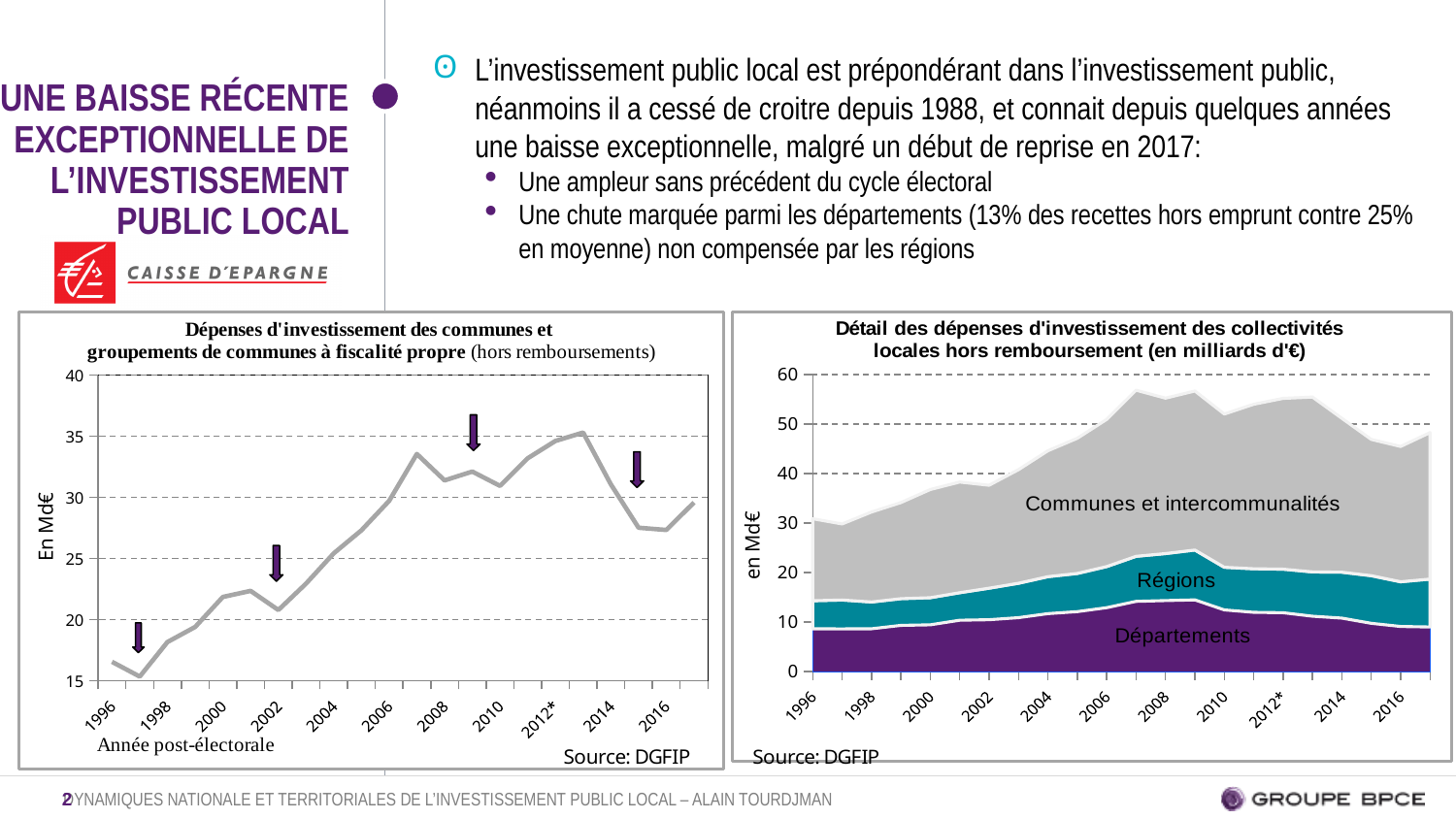
In the right chart, is the total for 1996 greater or less than 40? less In the right chart, which series is at the bottom of the stack? Départements In the left chart, is the value for 2007 greater or less than 30? greater What kind of chart is the right chart, 'Détail des dépenses d'investissement des collectivités locales hors remboursement'? stacked area chart In the left chart, which year has the lowest value? 1997 In the left chart, is the value for 2015 greater or less than 30? less What kind of chart is the left chart, 'Dépenses d'investissement des communes et groupements de communes à fiscalité propre'? line chart In the left chart, do the values rise or fall between 2002 and 2007? rise In the left chart, do the values rise or fall between 2013 and 2015? fall How many series are shown in the right chart? 3